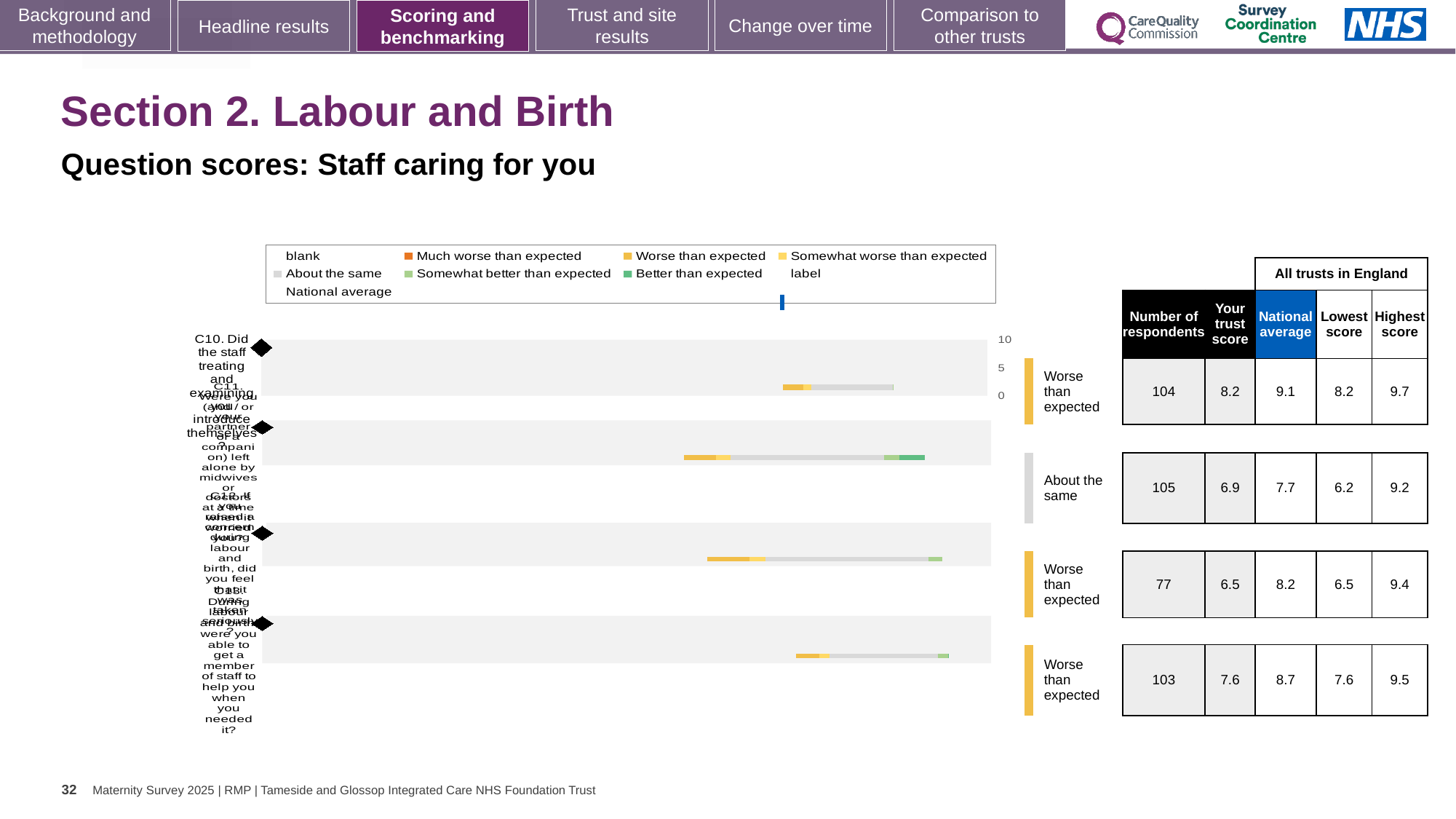
In the table, what is the 'Your trust score' value for the second row? 6.9 Which row in the table has the highest number of respondents? the second row (105) What heading spans the National average, Lowest score and Highest score columns of the table? All trusts in England In the table next to the chart, what is the number of respondents for the first (top) row? 104 Which row in the table has the lowest 'Your trust score'? the third row (6.5) How many of the four rows are labelled 'Worse than expected'? 3 For the fourth (bottom) row, what is the difference between the national average and the trust score? 1.1 For the first (top) row, which is larger: the trust score or the national average? the national average (9.1) How many question rows (bars) are plotted in the chart? 4 In the table, what is the national average for the third row? 8.2 What type of chart is shown on the slide? bar chart In the table, what is the highest score for the first (top) row? 9.7